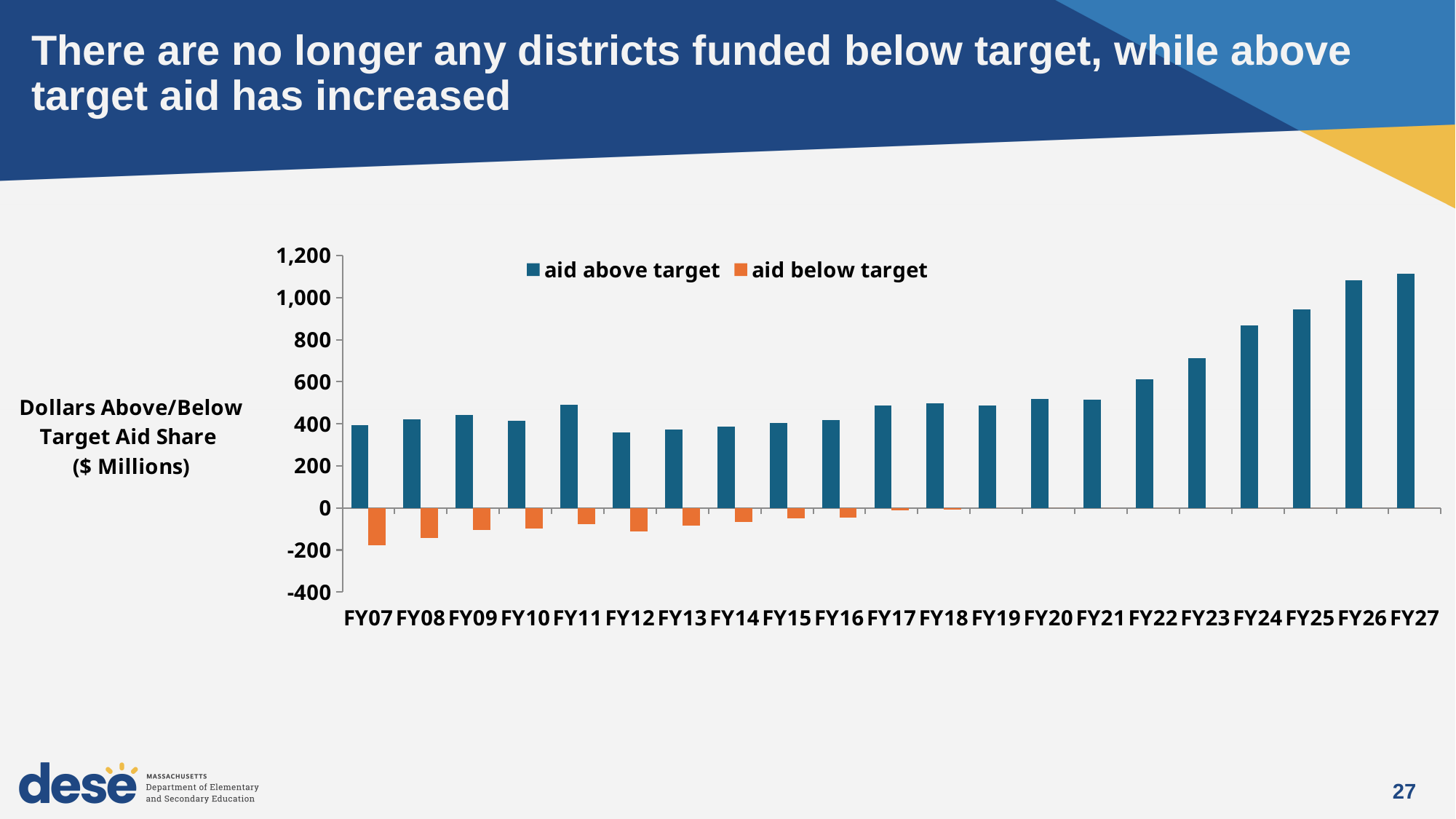
Is the value for aid above target in FY27 greater or less than 1,000? greater Is the value for aid below target in FY07 greater or less than -100? less Which fiscal year has the highest value for aid above target? FY27 How many fiscal years are shown on the x axis? 21 How many series does the legend list? 2 Does aid above target rise or fall from FY22 to FY27? rise What colour represents aid below target in the chart? orange Which is larger, aid above target in FY23 or in FY22? FY23 Is the value for aid above target in FY23 greater or less than 600? greater Which fiscal year has the most negative value for aid below target? FY07 What kind of chart is shown on the slide? bar chart